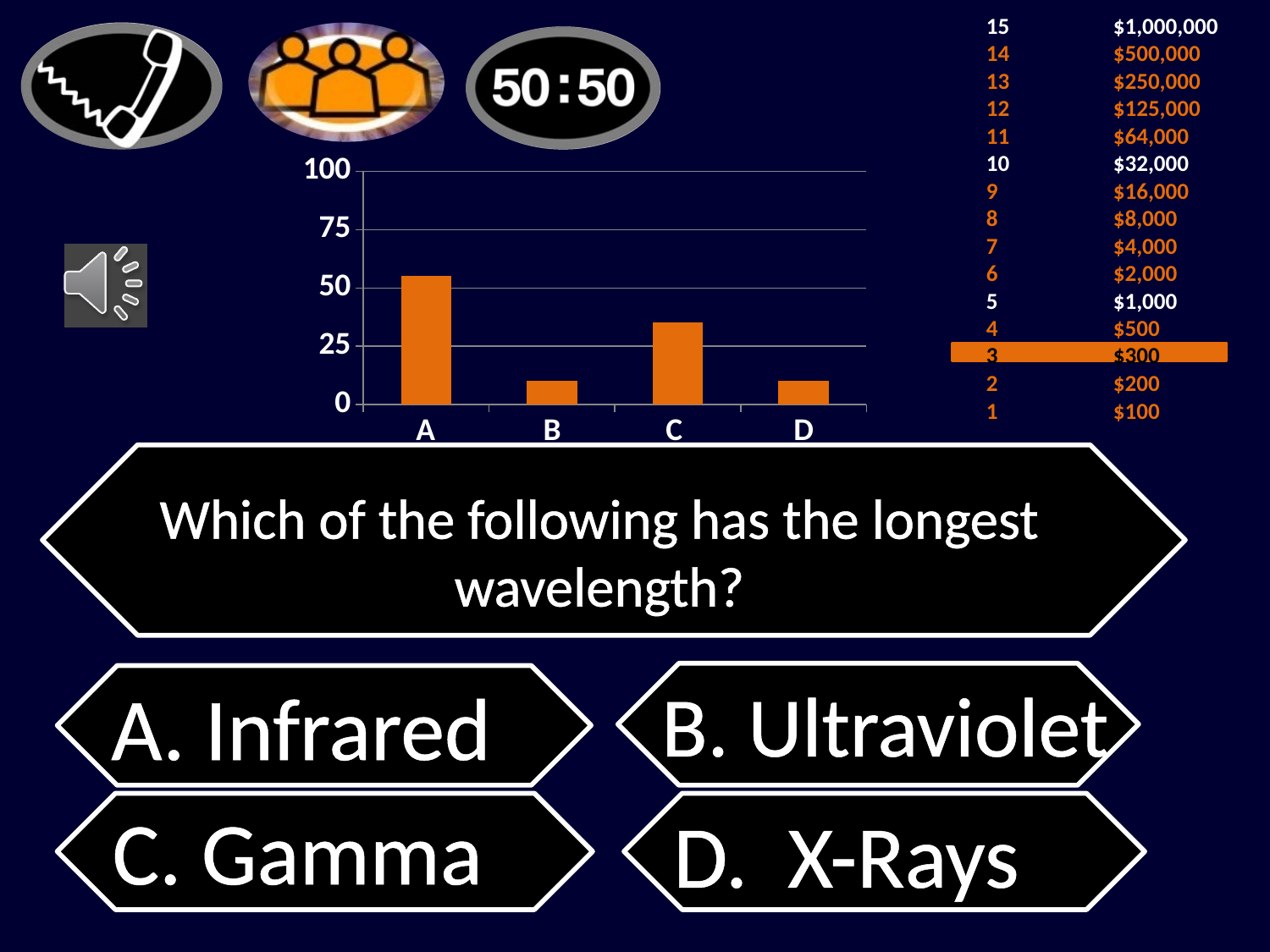
Which is larger, the value for A or the value for C? A Is the value for A greater or less than 25? greater Which category has the highest bar in the chart? A Is the value for C greater or less than 50? less Is the value for C greater or less than 25? greater How many categories are shown on the x axis of the chart? 4 Which is larger, the value for C or the value for B? C What is the highest value shown on the chart's y axis? 100 What kind of chart is shown on the slide? bar chart What colour are the bars in the chart? orange